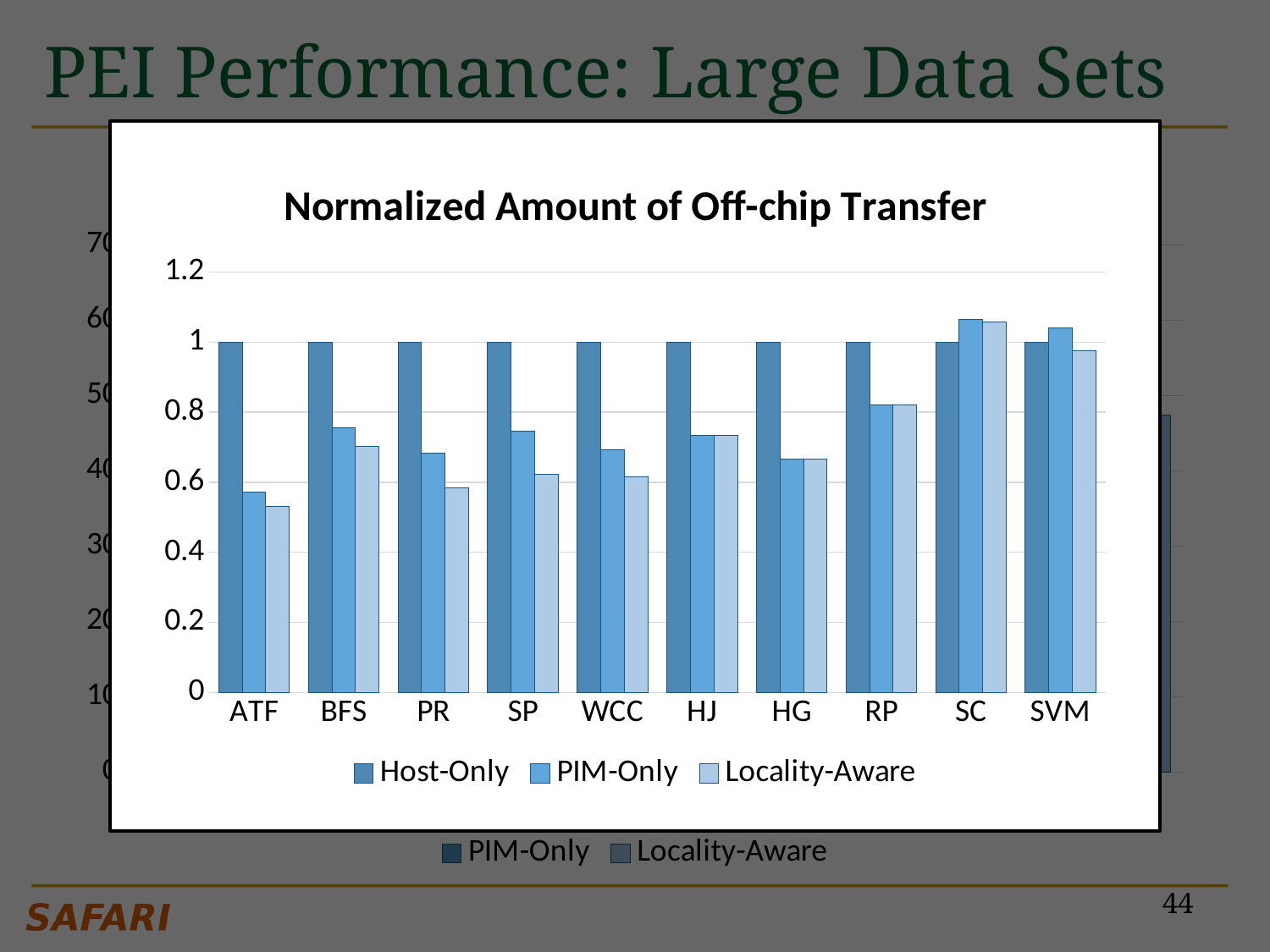
How many categories are shown on the x axis of the 'Normalized Amount of Off-chip Transfer' chart? 10 In the 'Normalized Amount of Off-chip Transfer' chart, is the PIM-Only value for HG greater or less than 0.6? greater What kind of chart is the 'Normalized Amount of Off-chip Transfer' chart? bar chart In the 'Normalized Amount of Off-chip Transfer' chart, which is larger for SVM: PIM-Only or Locality-Aware? PIM-Only In the 'Normalized Amount of Off-chip Transfer' chart, is the PIM-Only value for BFS greater or less than 0.8? less How many series does the legend of the 'Normalized Amount of Off-chip Transfer' chart list? 3 In the 'Normalized Amount of Off-chip Transfer' chart, is the Locality-Aware value for ATF greater or less than 0.6? less In the 'Normalized Amount of Off-chip Transfer' chart, what is the Host-Only value for ATF? 1 In the 'Normalized Amount of Off-chip Transfer' chart, which category has the lowest Locality-Aware value? ATF In the 'Normalized Amount of Off-chip Transfer' chart, which is larger for ATF: PIM-Only or Locality-Aware? PIM-Only In the 'Normalized Amount of Off-chip Transfer' chart, which category has the highest Locality-Aware value? SC